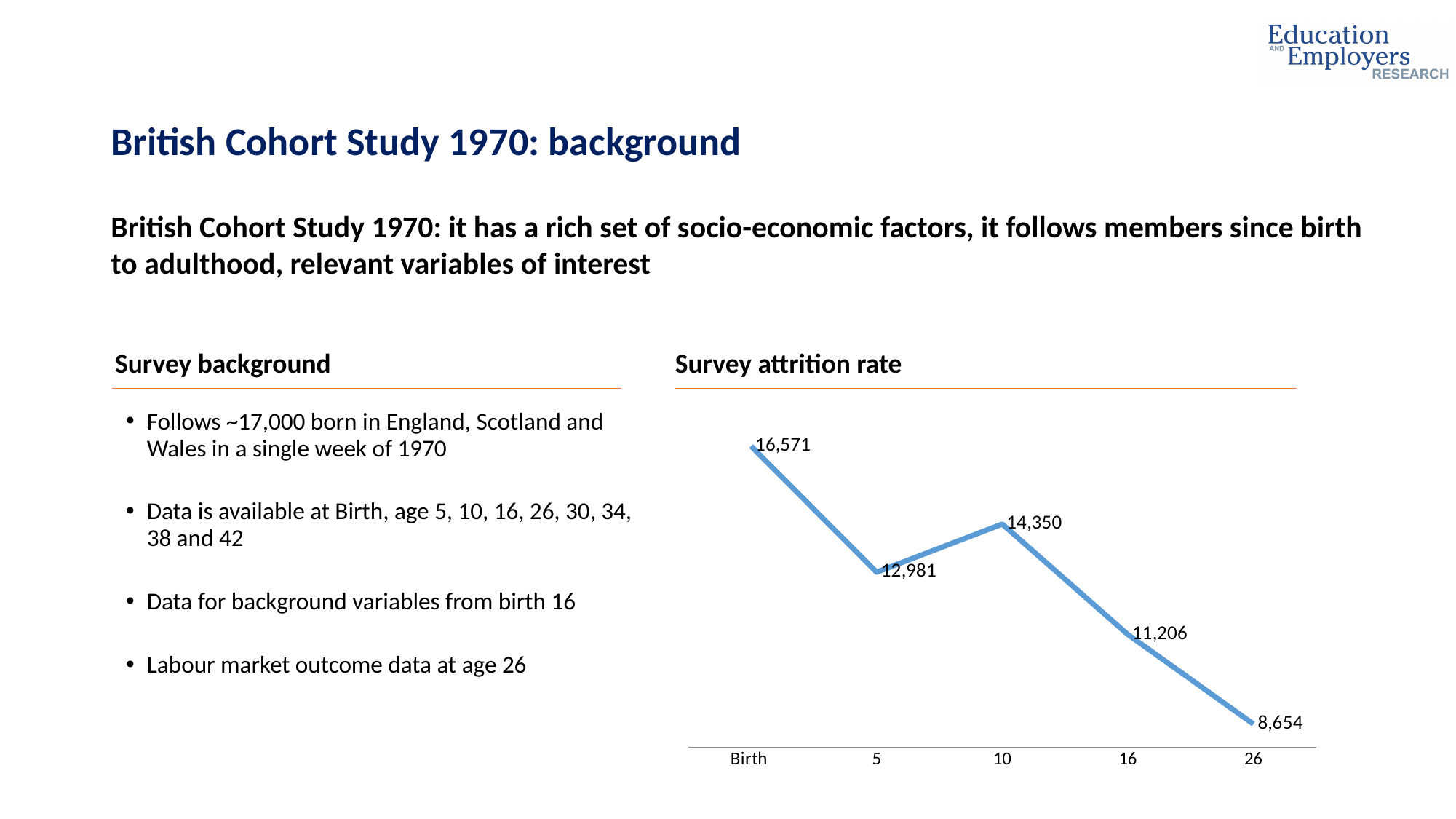
What is the value at age 10 in the Survey attrition rate chart? 14,350 What is the value at age 26 in the Survey attrition rate chart? 8,654 Which is larger in the Survey attrition rate chart: the value at age 5 or the value at age 10? age 10 What is the value at age 16 in the Survey attrition rate chart? 11,206 What is the value at age 5 in the Survey attrition rate chart? 12,981 Which point on the x axis has the lowest value in the Survey attrition rate chart? 26 What is the difference between the value at age 10 and the value at age 5 in the Survey attrition rate chart? 1,369 How many data points are plotted in the Survey attrition rate chart? 5 What is the difference between the value at Birth and the value at age 26 in the Survey attrition rate chart? 7,917 What is the value at Birth in the Survey attrition rate chart? 16,571 Which point on the x axis has the highest value in the Survey attrition rate chart? Birth What kind of chart is the Survey attrition rate chart? line chart